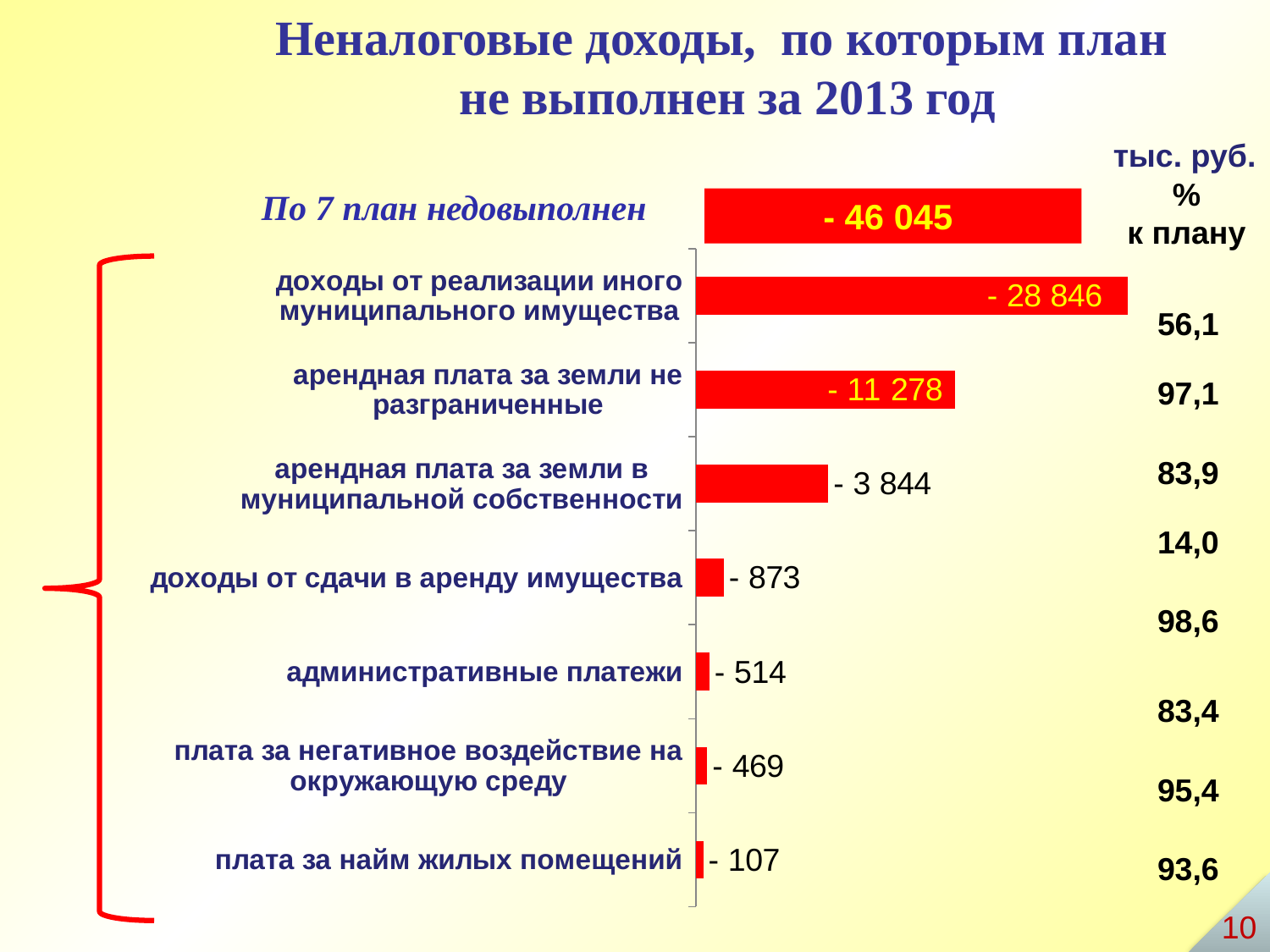
Which category has the smallest shortfall (shortest bar)? плата за найм жилых помещений What is the difference between the shortfall for "доходы от сдачи в аренду имущества" (873) and "плата за негативное воздействие на окружающую среду" (469)? 404 How many categories of non-tax revenue are plotted as bars below the total bar? 7 What is the value shown for "административные платежи"? - 514 What is the value shown for "плата за найм жилых помещений"? - 107 What is the value shown for "арендная плата за земли в муниципальной собственности"? - 3 844 What is the value shown for "арендная плата за земли не разграниченные"? - 11 278 Which has the larger shortfall: "арендная плата за земли не разграниченные" or "арендная плата за земли в муниципальной собственности"? арендная плата за земли не разграниченные Which category has the largest shortfall (longest bar)? доходы от реализации иного муниципального имущества What is the value shown for "доходы от реализации иного муниципального имущества"? - 28 846 What kind of chart is shown on the slide? bar chart What total shortfall value is shown on the top bar labelled "По 7 план недовыполнен"? - 46 045